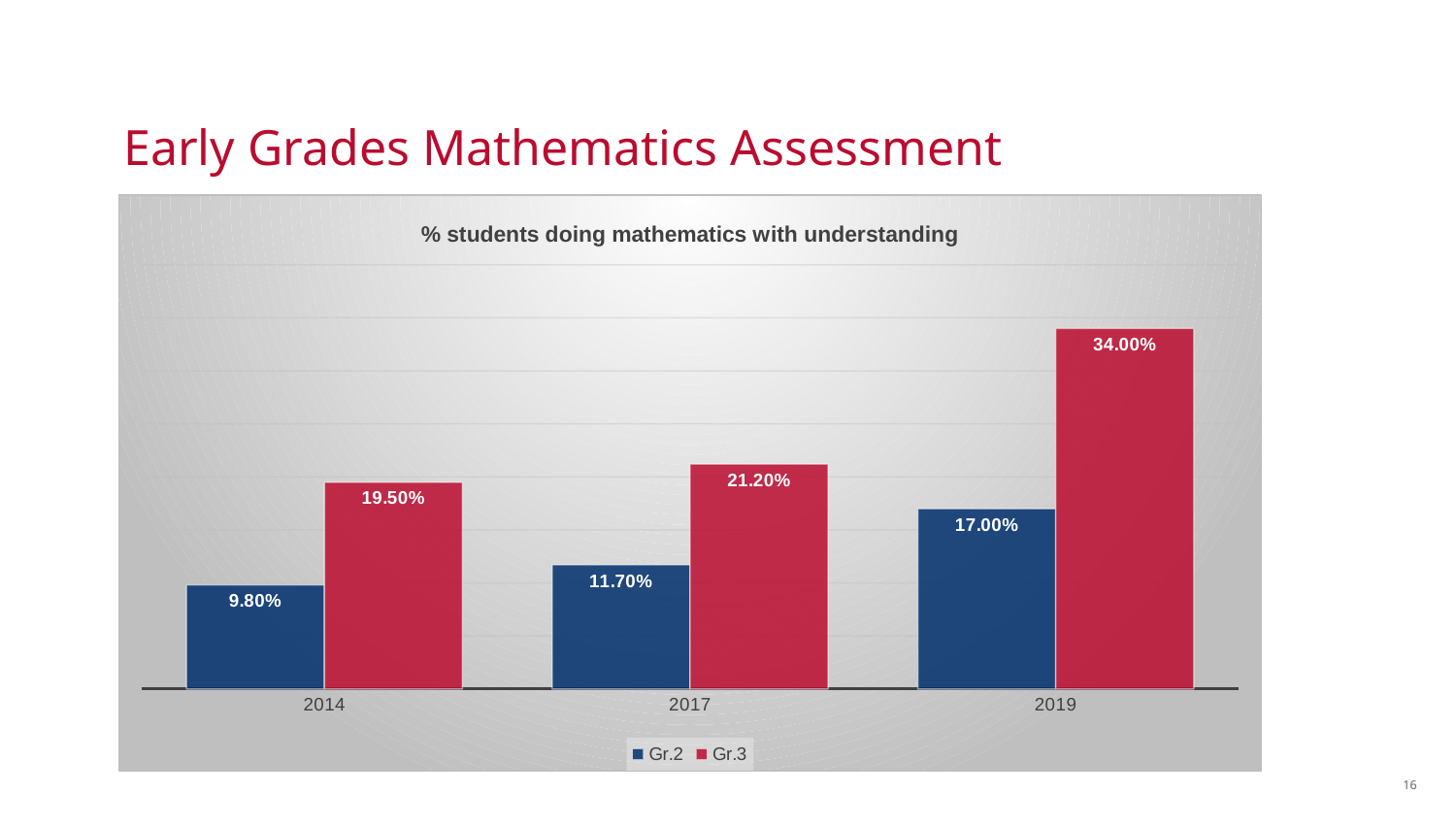
What is the Gr.2 value for 2014? 9.80% What is the difference between the Gr.3 and Gr.2 values in 2019? 17.00% Which is larger in 2017, the Gr.2 value or the Gr.3 value? Gr.3 Which year has the highest Gr.2 value? 2019 What is the Gr.3 value for 2017? 21.20% Do the Gr.3 values rise or fall from 2014 to 2019? Rise What is the Gr.3 value for 2019? 34.00% What is the title of the chart? % students doing mathematics with understanding How many series does the legend list? 2 What kind of chart is shown on the slide? Bar chart How many years are shown on the x axis? 3 Which year has the lowest Gr.3 value? 2014